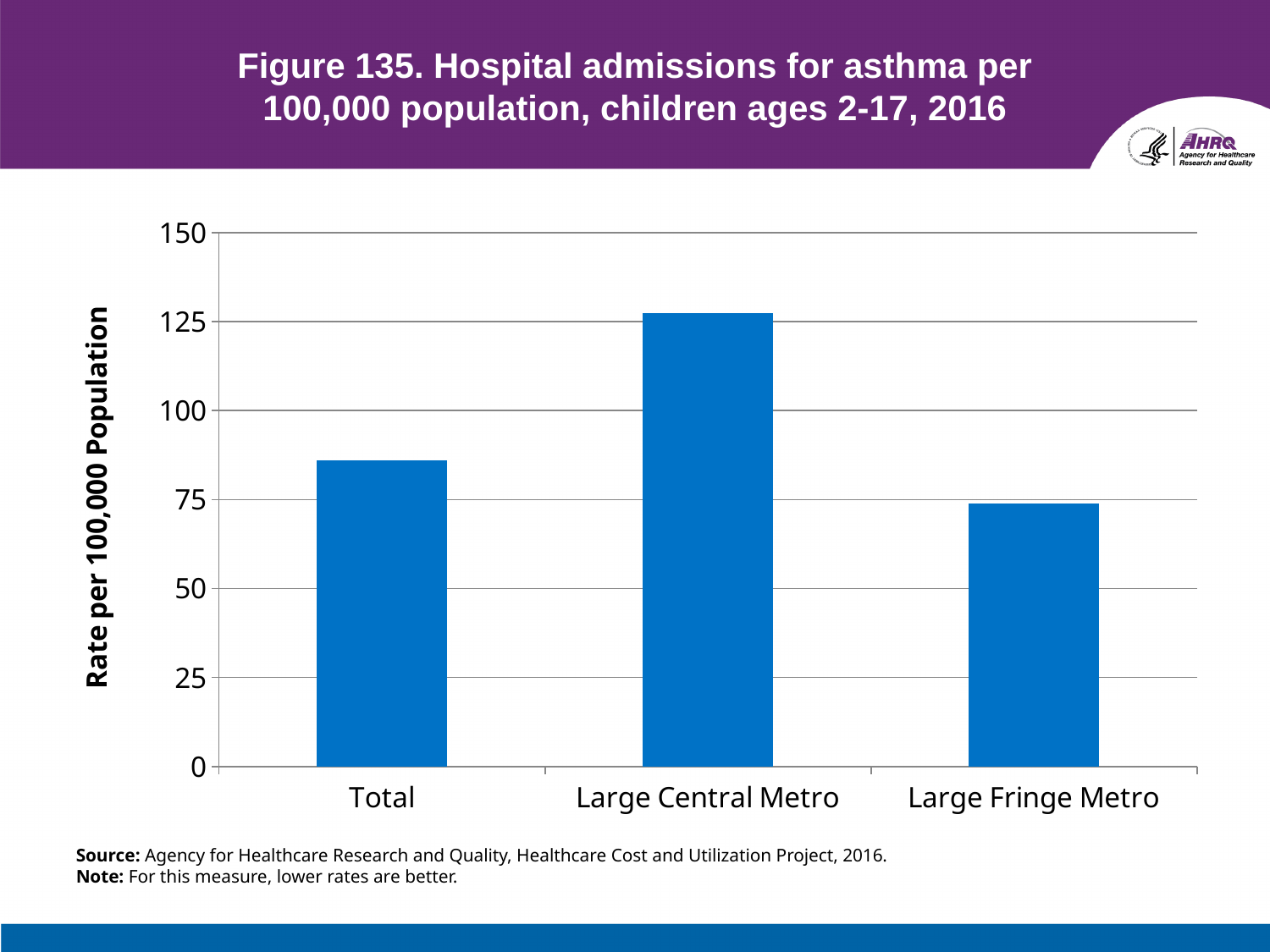
What is the label of the y axis? Rate per 100,000 Population Is the value for Large Central Metro greater or less than 125? greater Which category has the highest hospital admission rate for asthma? Large Central Metro What year does the chart's data refer to? 2016 Which is larger, the value for Total or the value for Large Fringe Metro? Total Is the value for Total greater or less than 100? less Is the value for Total greater or less than 75? greater How many categories are shown on the x axis? 3 What kind of chart is shown on the slide? Bar chart Which is larger, the value for Large Central Metro or the value for Total? Large Central Metro Which category has the lowest hospital admission rate for asthma? Large Fringe Metro